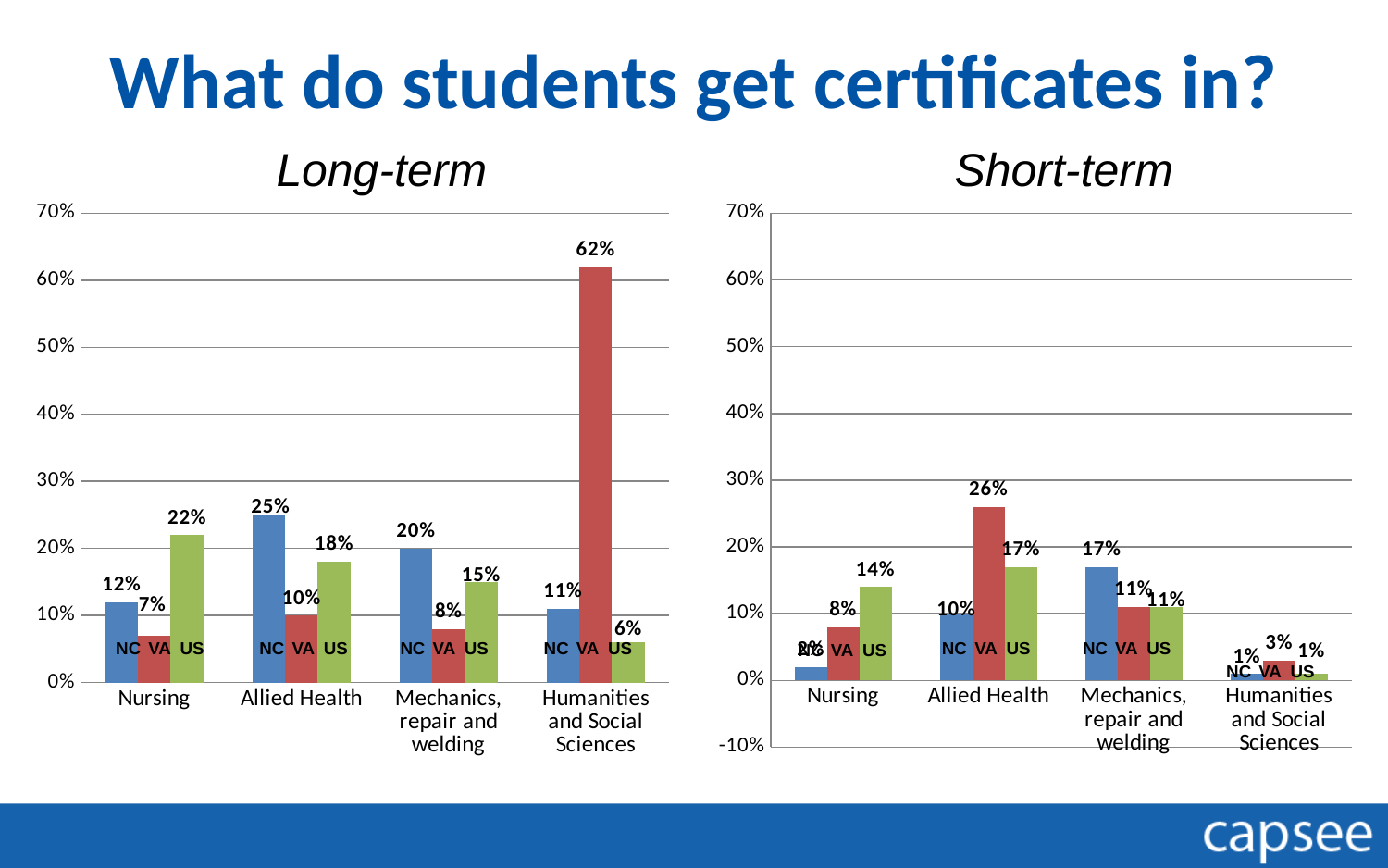
In the Long-term chart, what is the difference between the NC and VA values for Allied Health? 15% In the Long-term chart, which category has the lowest US value? Humanities and Social Sciences In the Long-term chart, what is the US value for Nursing? 22% In the Long-term chart, which bar is the highest overall? VA, Humanities and Social Sciences What type of chart is the Long-term chart? bar chart In the Short-term chart, what is the NC value for Mechanics, repair and welding? 17% In the Short-term chart, is the VA value for Allied Health greater or less than 20%? greater How many categories are shown on the x axis of the Short-term chart? 4 In the Short-term chart, what is the difference between the VA and US values for Allied Health? 9% In the Long-term chart, what is the VA value for Humanities and Social Sciences? 62% In the Long-term chart, which is larger for Mechanics, repair and welding: the NC value or the US value? NC In the Short-term chart, what is the VA value for Allied Health? 26%